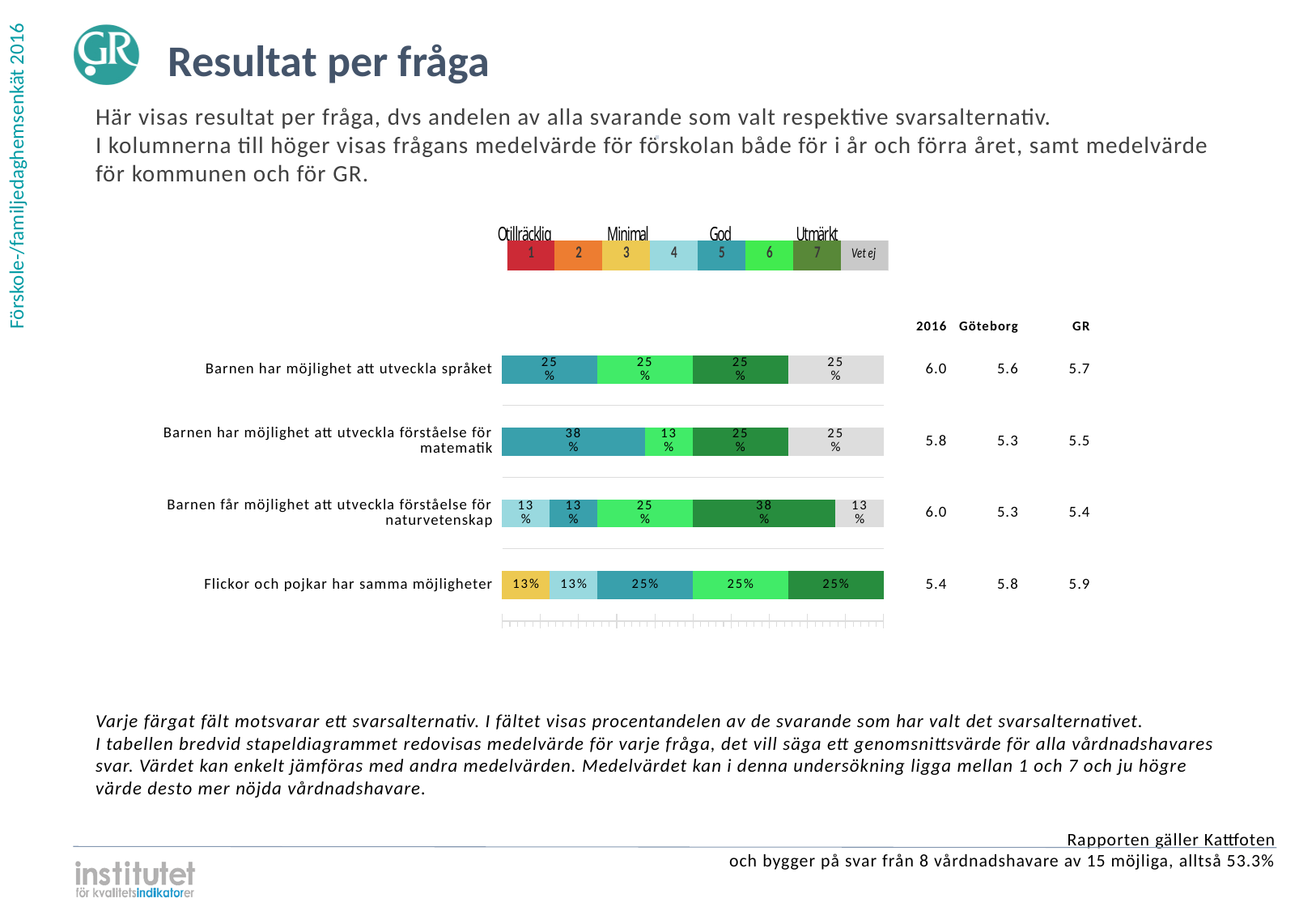
What percentage chose answer 7 for 'Barnen får möjlighet att utveckla förståelse för naturvetenskap'? 38% What percentage of respondents answered 'Vet ej' for 'Barnen har möjlighet att utveckla språket'? 25% What is the 2016 mean value shown for 'Flickor och pojkar har samma möjligheter'? 5.4 For 'Barnen har möjlighet att utveckla förståelse för matematik', which is larger: the share for answer 5 or the share for answer 6? Answer 5 For 'Barnen får möjlighet att utveckla förståelse för naturvetenskap', what is the difference between the share for answer 7 and the share for answer 4? 25 percentage points How many coloured segments make up the bar for 'Flickor och pojkar har samma möjligheter'? 5 What percentage chose answer 5 for 'Barnen har möjlighet att utveckla förståelse för matematik'? 38% Which question has the largest share of respondents choosing answer 7 (dark green)? Barnen får möjlighet att utveckla förståelse för naturvetenskap How many answer alternatives does the legend above the chart list? 8 What does the grey segment at the end of the bars represent according to the legend? Vet ej How many questions (categories) are plotted in the bar chart? 4 What kind of chart is shown on the slide? Stacked bar chart